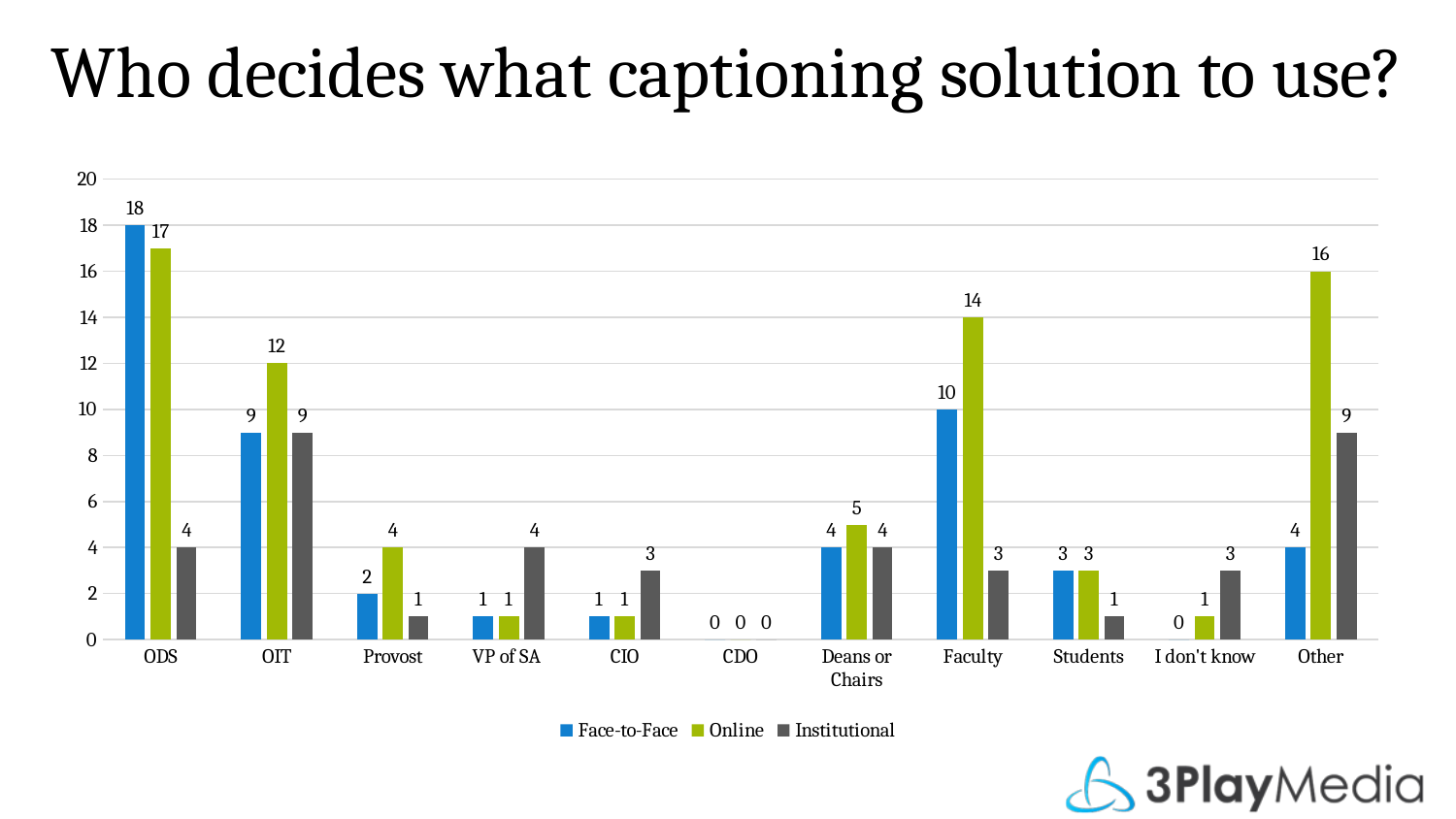
How many categories are shown on the x axis? 11 What is the title of the chart? Who decides what captioning solution to use? What is the Face-to-Face value for ODS? 18 Which category has the highest Online value? ODS Which is larger for OIT: the Online value or the Institutional value? Online How many series does the legend list? 3 What is the Online value for Faculty? 14 What is the difference between the Online and Face-to-Face values for Other? 12 Which category has the lowest Institutional value? CDO Which series is shown in green? Online What kind of chart is shown on the slide? Bar chart What is the Institutional value for Other? 9